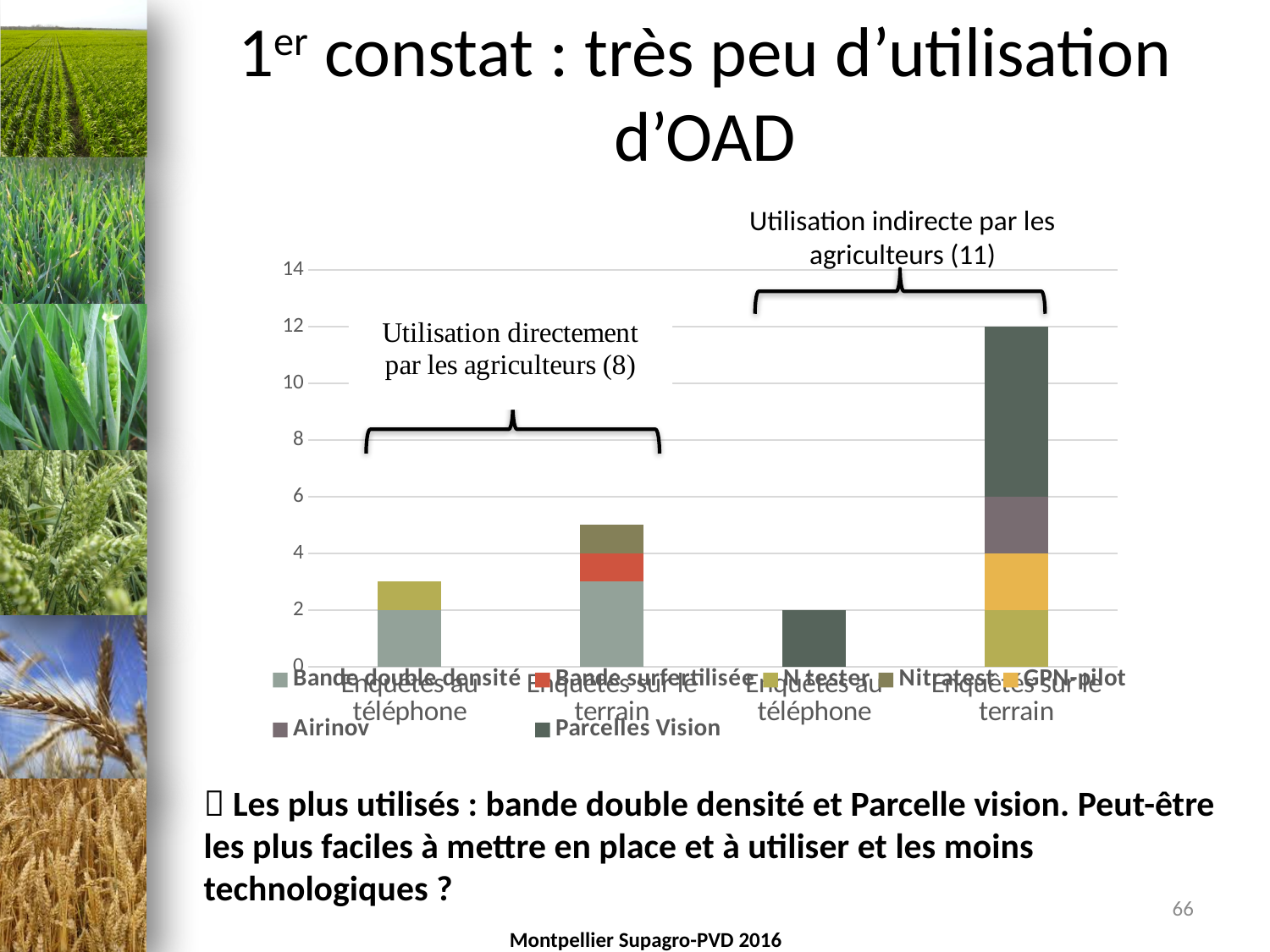
Which bar is the shortest in the chart? Enquêtes au téléphone (under Utilisation indirecte par les agriculteurs) What kind of chart is shown on the slide? stacked bar chart How many bars are plotted in the chart? 4 How many series does the chart legend list? 7 Which series forms the top segment of the rightmost bar? Parcelles Vision Which bar is the tallest in the chart? Enquêtes sur le terrain (under Utilisation indirecte par les agriculteurs) Is the total of the second bar (Enquêtes sur le terrain, direct use) greater or less than 4? greater Which is taller: the first bar (Enquêtes au téléphone, direct use) or the second bar (Enquêtes sur le terrain, direct use)? Enquêtes sur le terrain (direct use) What is the total height of the rightmost bar (Enquêtes sur le terrain, indirect use)? 12 Is the total of the leftmost bar (Enquêtes au téléphone, direct use) greater or less than 4? less According to the annotation above the right-hand bars, how many cases are counted as 'Utilisation indirecte par les agriculteurs'? 11 What is the total height of the third bar (Enquêtes au téléphone, indirect use)? 2